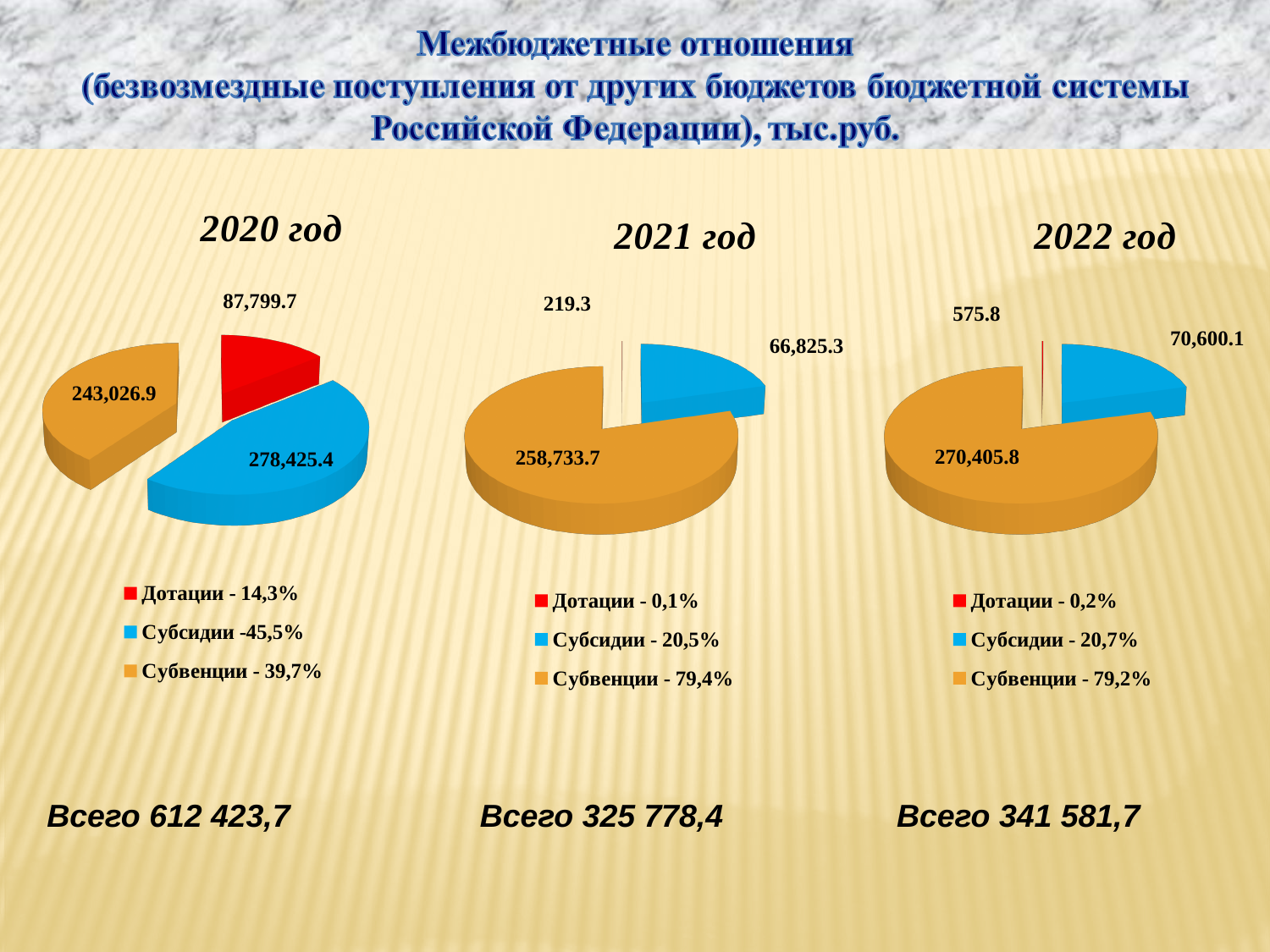
In the 2022 год chart, what is the value for Субсидии? 70,600.1 In the 2020 год chart, what is the value for Дотации? 87,799.7 In the 2021 год chart, what share of the pie does Субвенции take according to the legend? 79,4% In the 2021 год chart, what is the value for Субвенции? 258,733.7 What kind of chart is used for 2021 год? Pie chart How many series does the legend of the 2022 год chart list? 3 In the 2022 год chart, which category has the smallest value? Дотации In the 2020 год chart, what is the difference between the values for Субсидии and Субвенции? 35,398.5 In the 2021 год chart, which is larger: the value for Субсидии or the value for Дотации? Субсидии In the 2022 год chart, what share of the pie does Субсидии take according to the legend? 20,7% In the 2020 год chart, which category has the largest value? Субсидии In the 2020 год chart, what is the value for Субсидии? 278,425.4